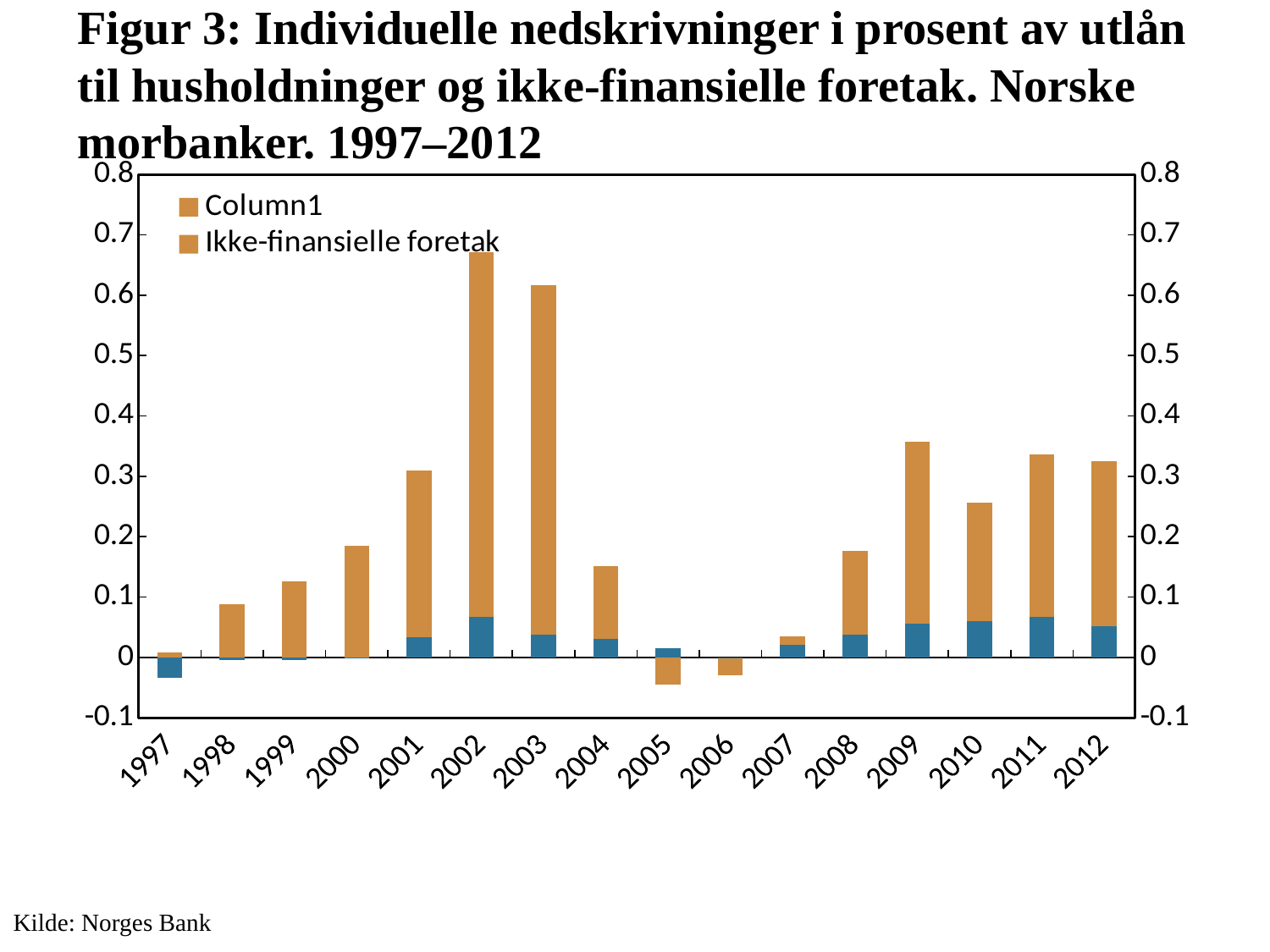
Which year has the tallest bar in the chart? 2002 How many series does the legend list? 2 What is the second entry listed in the chart legend? Ikke-finansielle foretak Is the total bar height for 2009 greater or less than 0.3? greater Is the total bar height for 1998 greater or less than 0.1? less Is the total bar height for 2000 greater or less than 0.2? less Which year has the taller bar, 2002 or 2003? 2002 How many years are shown on the x axis of the chart? 16 Do the bar heights rise or fall from 2003 to 2006? fall Which year has the taller bar, 2009 or 2010? 2009 What kind of chart is shown on the slide? Stacked bar chart